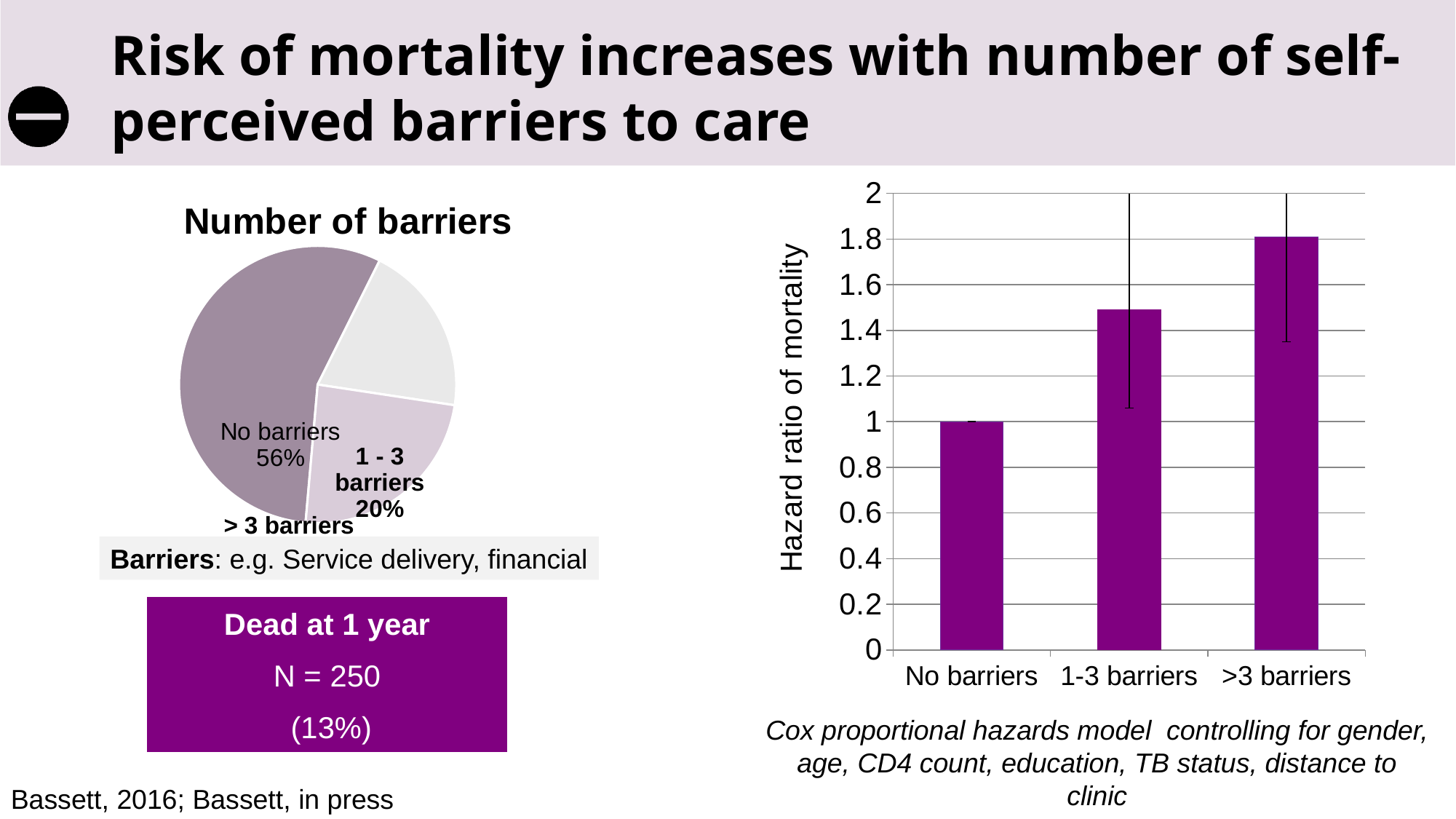
In the pie chart titled 'Number of barriers', how many slices are there? 3 In the pie chart titled 'Number of barriers', how many percentage points larger is the 'No barriers' share than the '1 - 3 barriers' share? 36 In the pie chart titled 'Number of barriers', what percentage of patients reported 1 - 3 barriers? 20% In the bar chart on the right, how many categories are shown on the x axis? 3 What kind of chart is the chart on the right of the slide showing hazard ratio of mortality? Bar chart In the bar chart on the right, what is the hazard ratio of mortality for 'No barriers'? 1 In the bar chart on the right, which category has the highest hazard ratio of mortality? >3 barriers In the pie chart titled 'Number of barriers', which category has the largest slice? No barriers In the bar chart on the right, do the hazard ratios rise or fall as the number of barriers increases along the x axis? Rise In the pie chart titled 'Number of barriers', what percentage of patients reported no barriers? 56% What kind of chart is the chart on the left of the slide? Pie chart In the bar chart on the right, is the hazard ratio for '1-3 barriers' greater or less than 1.2? greater